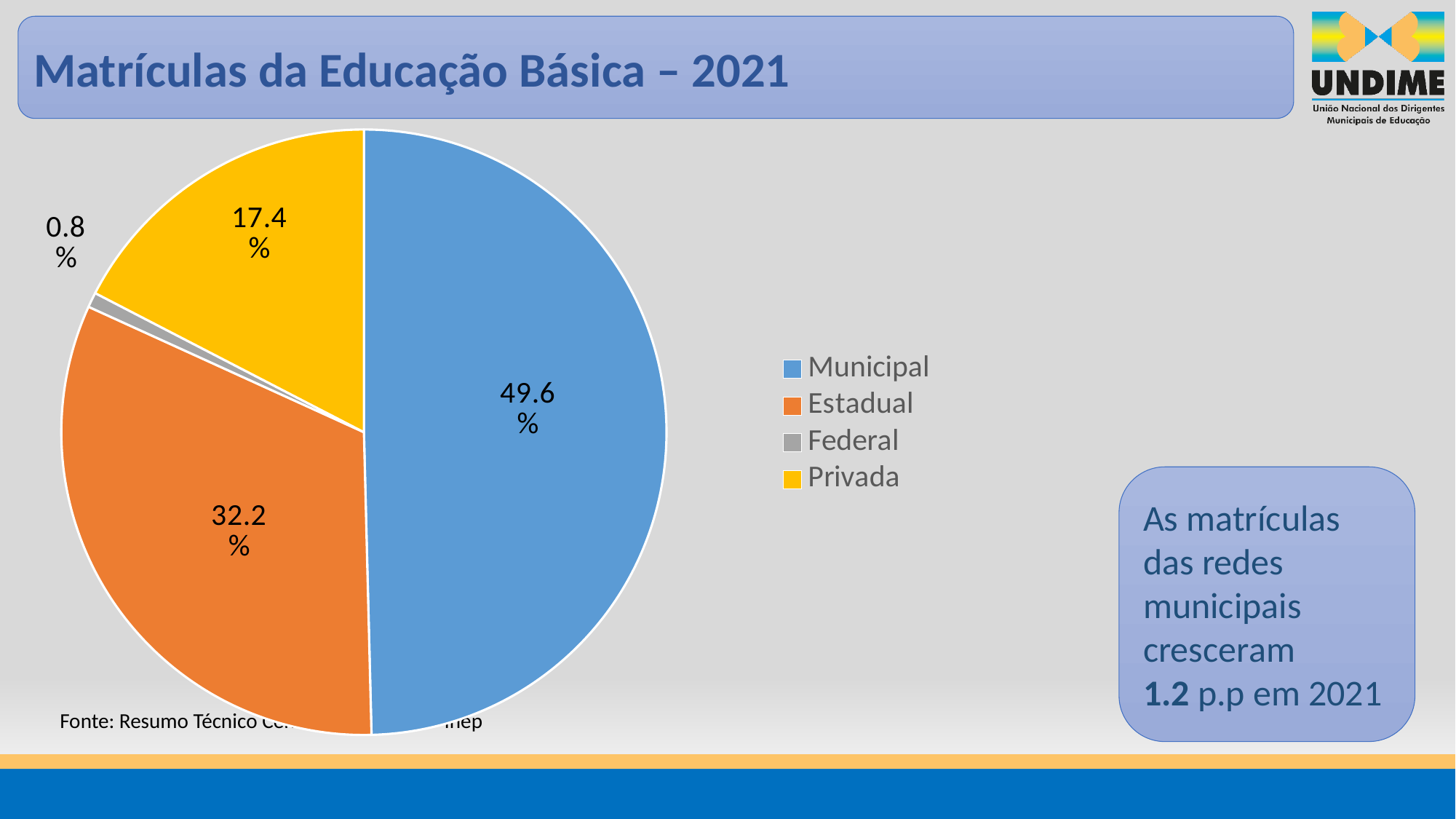
What is the title of the slide containing the chart? Matrículas da Educação Básica – 2021 Which is larger, Estadual or Privada? Estadual Which category has the smallest slice of the pie? Federal Which colour represents Privada in the legend? Yellow What is the value shown for Estadual? 32.2% What is the value shown for Federal? 0.8% What share of the pie does Municipal hold? 49.6% Which category has the largest slice of the pie? Municipal How many categories does the pie chart show? 4 What is the difference in percentage points between Municipal and Estadual? 17.4 What is the value shown for Privada? 17.4% What kind of chart is shown on the slide? Pie chart